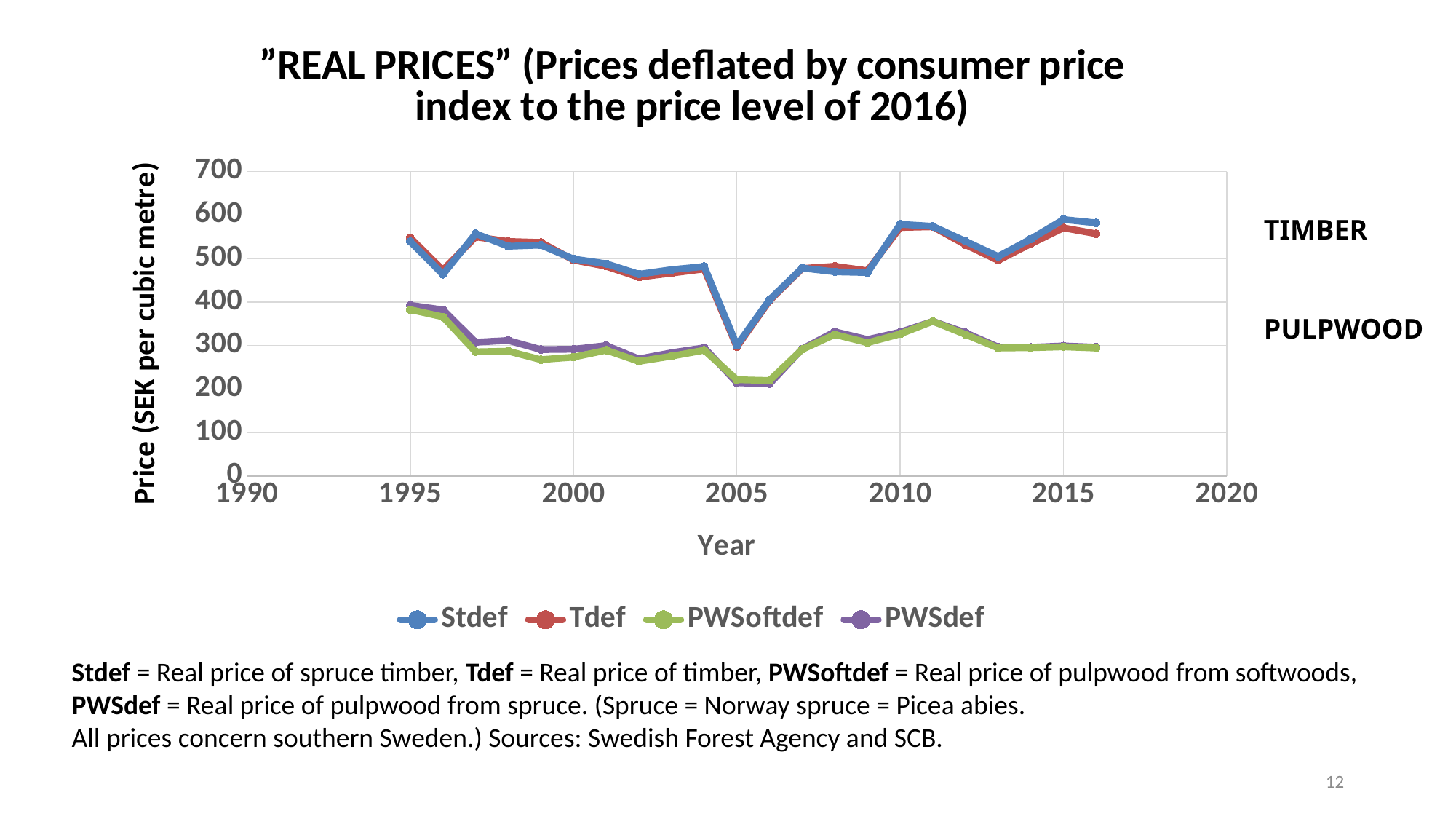
Is the value for PWSdef in 1995 greater or less than 300? greater In 2015, which is larger: Stdef or PWSdef? Stdef Does the Stdef series rise or fall between 2005 and 2010? rise What is the label of the vertical axis? Price (SEK per cubic metre) Which series are listed in the legend? Stdef, Tdef, PWSoftdef, PWSdef In which year is the Stdef series at its lowest? 2005 Is the value for PWSoftdef in 2006 greater or less than 300? less Is the value for Stdef in 2005 greater or less than 400? less What kind of chart is shown on the slide? line chart In which year is the PWSoftdef series at its highest? 2011 How many series does the legend list? 4